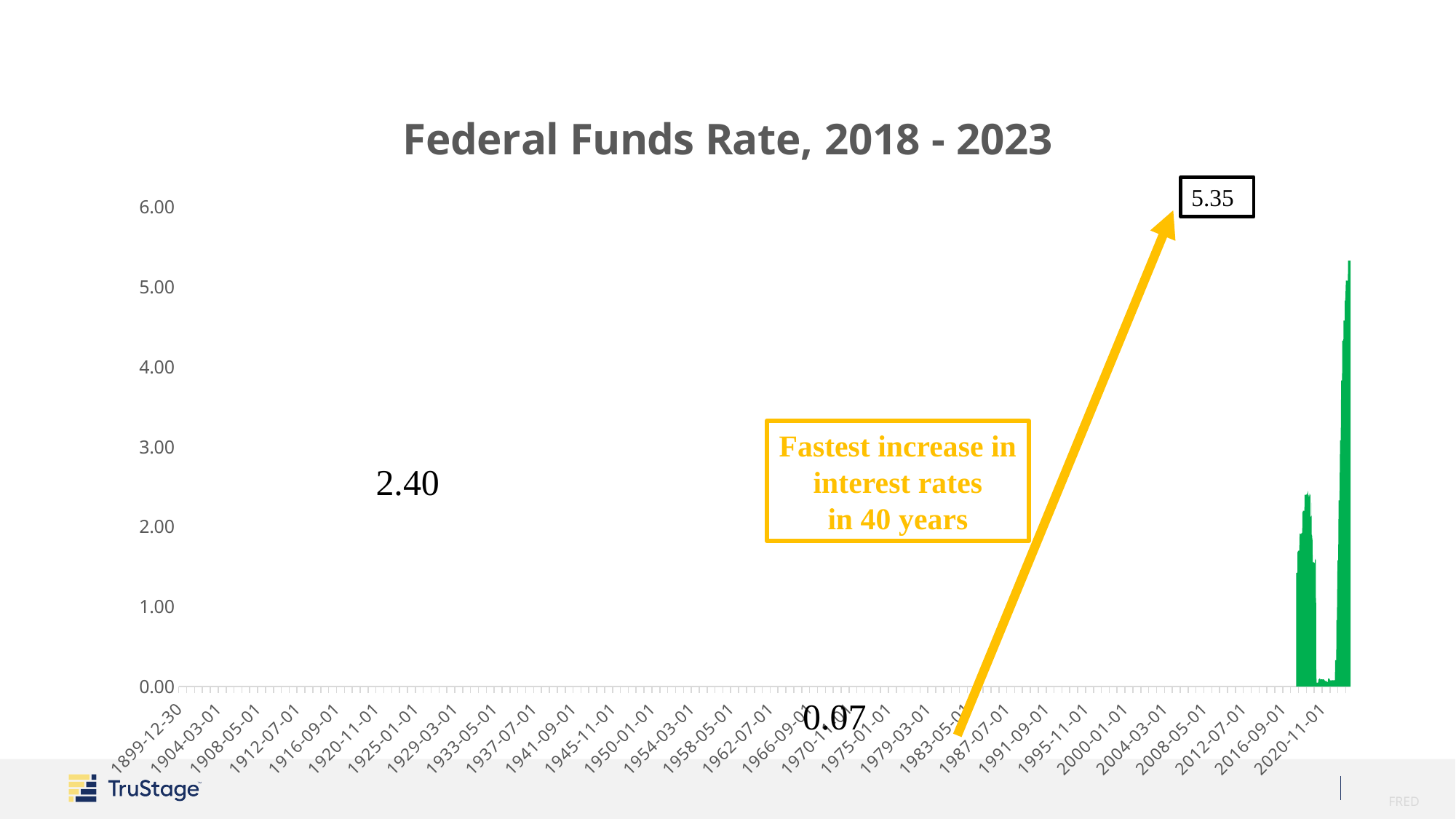
What is the highest value labelled on the chart? 5.35 Does the Federal Funds Rate rise or fall at the right-hand end of the chart? rise Is the final peak of the Federal Funds Rate greater or less than 5.00? greater What is the difference between the labelled peak of 5.35 and the labelled low of 0.07? 5.28 What is the lowest value labelled on the chart? 0.07 What is the highest tick value shown on the y-axis? 6.00 What value is labelled for the earlier, smaller peak in the Federal Funds Rate? 2.40 Which labelled peak is larger, 5.35 or 2.40? 5.35 What does the yellow callout box on the chart say? Fastest increase in interest rates in 40 years What is the title of the chart? Federal Funds Rate, 2018 - 2023 Is the earlier peak of the Federal Funds Rate greater or less than 3.00? less What is the difference between the two labelled peaks, 5.35 and 2.40? 2.95